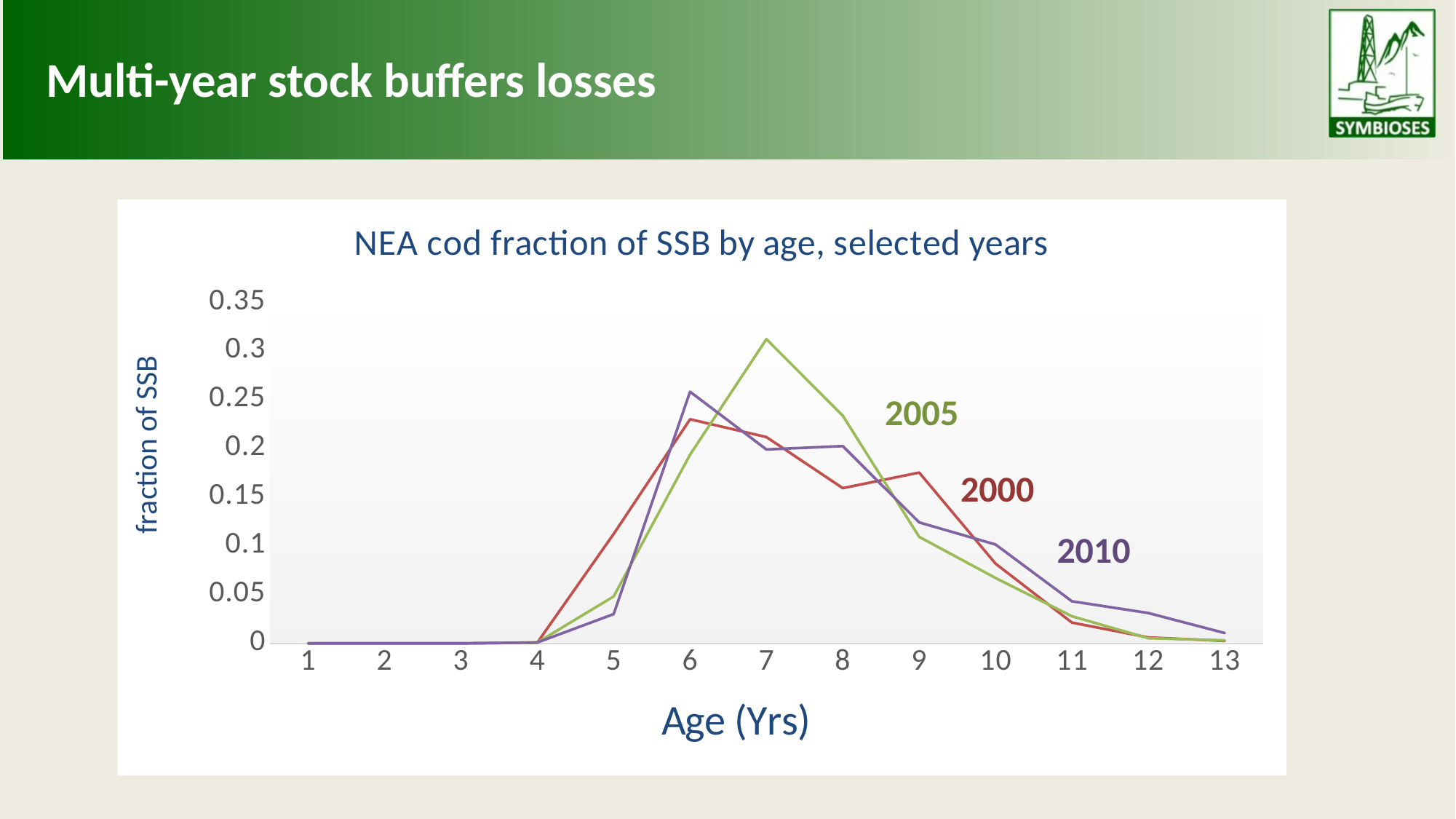
At age 9, which series has the larger value, 2000 or 2005? 2000 Which series reaches the highest peak value on the chart? 2005 At which age does the 2005 series reach its highest value? 7 At which age does the 2010 series reach its highest value? 6 How many series (years) are plotted on the chart? 3 What is the title of the chart? NEA cod fraction of SSB by age, selected years How many age categories are shown on the x axis? 13 What is the 2000 value at age 3? 0 Is the 2010 value at age 13 greater or less than 0.05? less Which year's line is drawn in green? 2005 What kind of chart is shown on the slide? line chart Is the 2005 value at age 7 greater or less than 0.25? greater